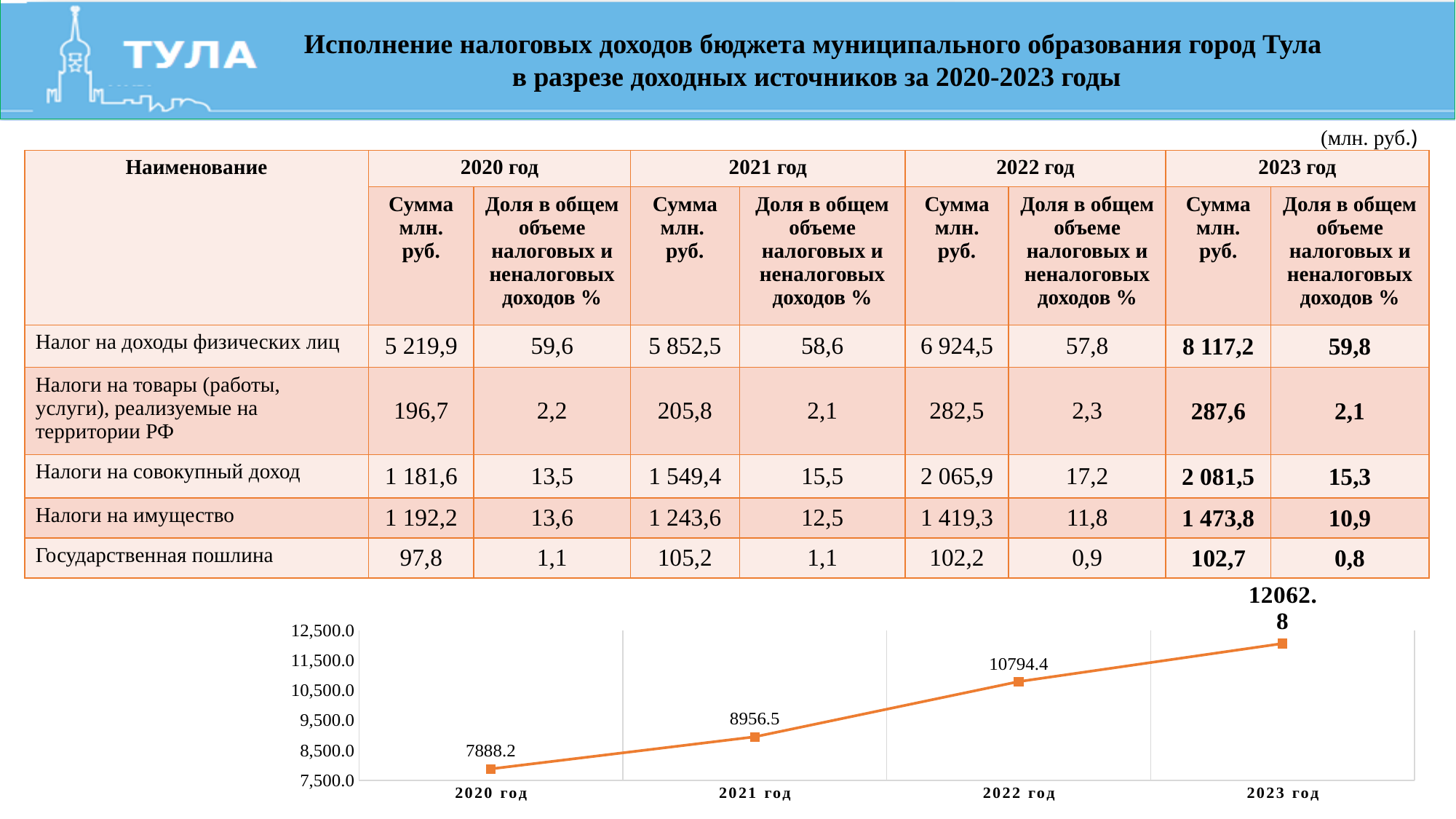
What is the value plotted for 2020 год on the line chart? 7888.2 What is the value plotted for 2022 год on the line chart? 10794.4 What is the value plotted for 2021 год on the line chart? 8956.5 How many data points are plotted on the line chart? 4 Do the values on the line chart rise or fall from 2020 год to 2023 год? rise What kind of chart is shown at the bottom of the slide? line chart On the line chart, is the value for 2022 год greater or less than 10,500.0? greater Which year has the lowest value on the line chart? 2020 год Which year has the highest value on the line chart? 2023 год On the line chart, what is the difference between the values for 2023 год and 2020 год? 4174.6 What is the value plotted for 2023 год on the line chart? 12062.8 What colour is the line on the line chart? orange